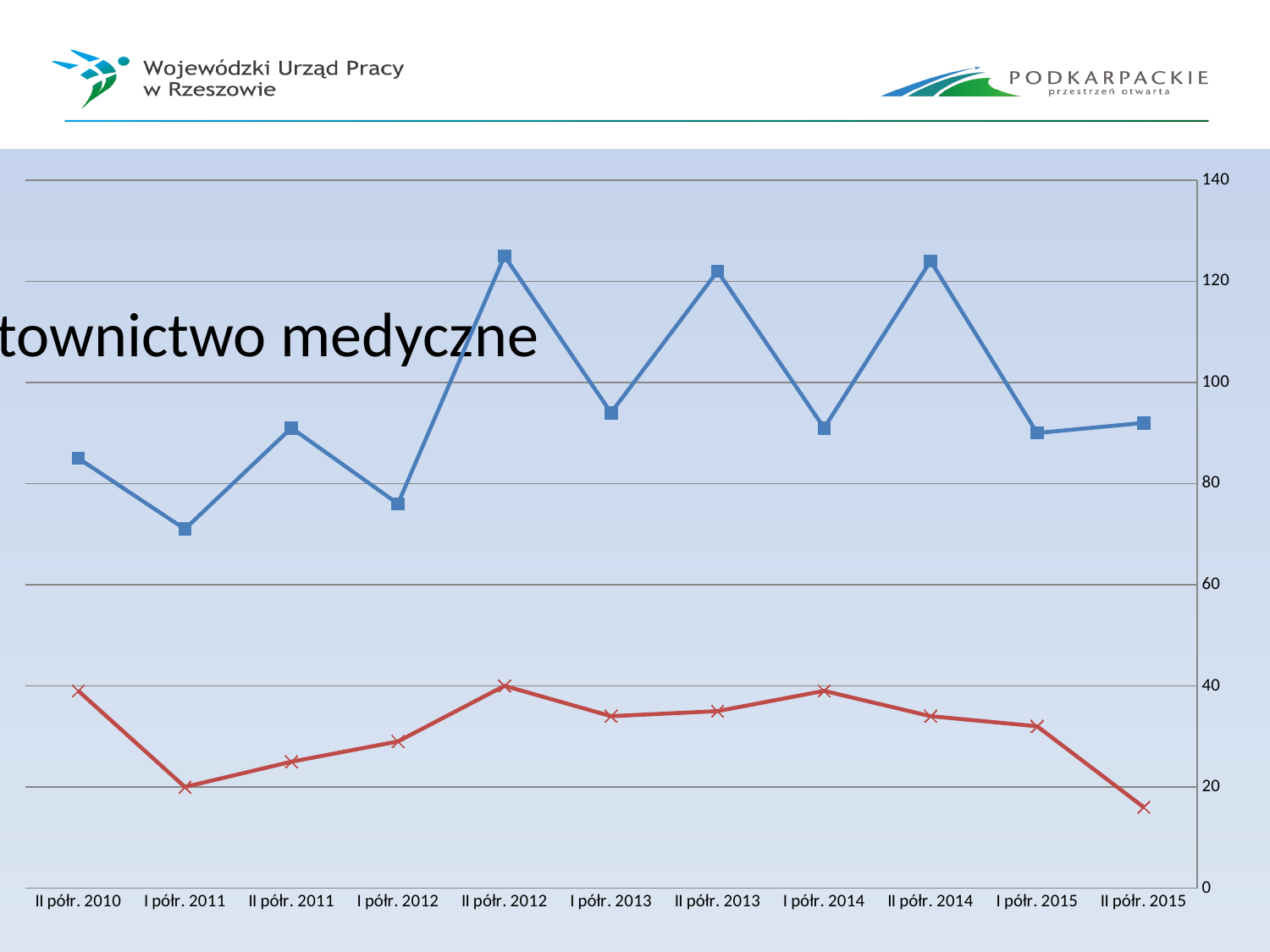
For the blue line with square markers, which is larger: the value for II półr. 2012 or the value for I półr. 2013? II półr. 2012 Is the value of the blue line with square markers for II półr. 2012 greater or less than 120? greater In which period does the red line with x markers reach its lowest value? II półr. 2015 Is the value of the blue line with square markers for I półr. 2011 greater or less than 80? less How many data series are plotted on the chart? 2 Is the value of the red line with x markers for II półr. 2015 greater or less than 20? less In which period does the blue line with square markers reach its lowest value? I półr. 2011 What kind of chart is shown on the slide? line chart What is the highest value shown on the vertical axis? 140 Does the red line with x markers rise or fall from I półr. 2014 to II półr. 2015? fall How many points (half-year periods) are plotted along the x axis? 11